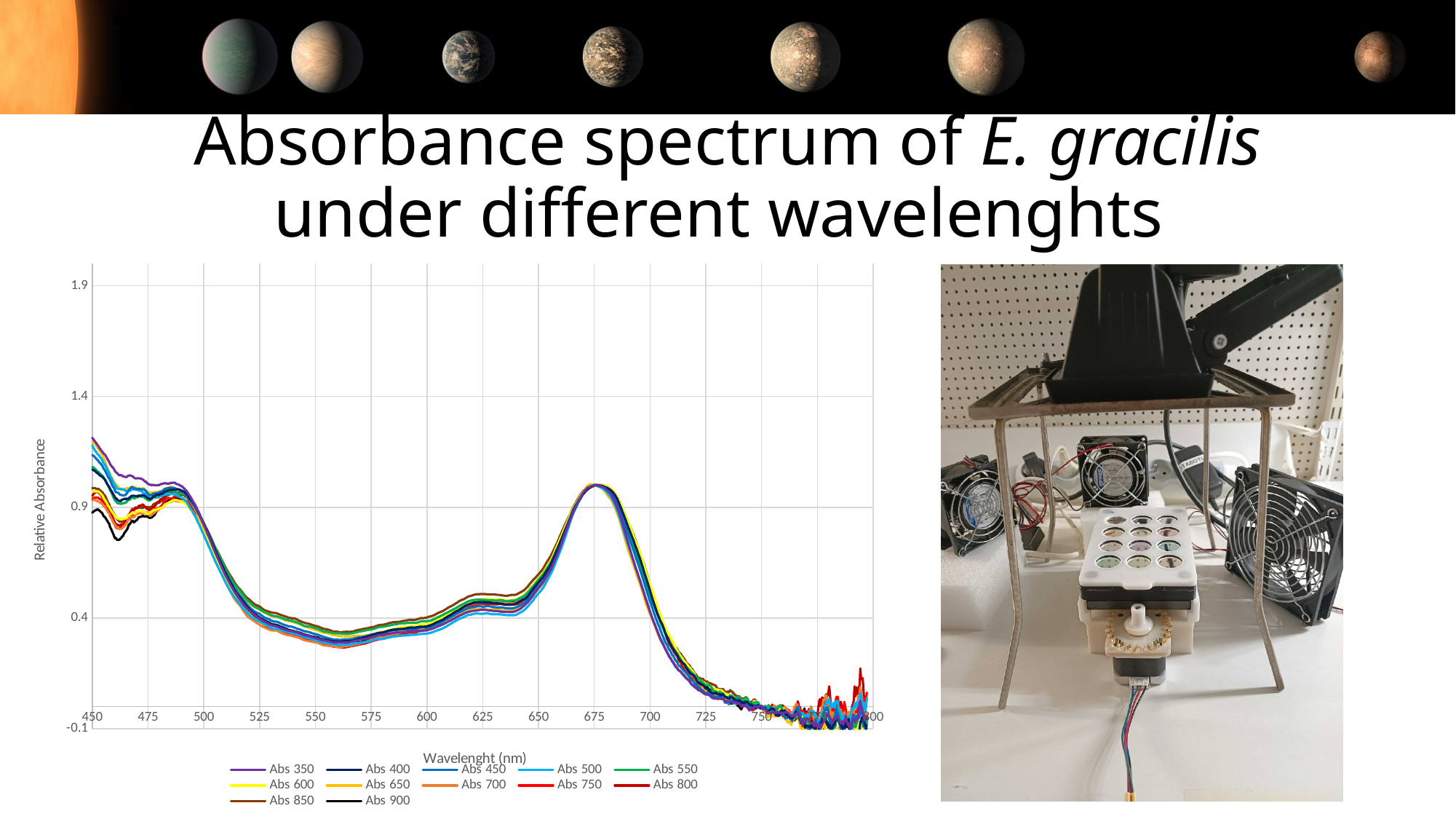
Is the value of the Abs 350 series at 450 nm greater or less than 0.9? greater Is the value of the Abs 600 series at 775 nm greater or less than 0.4? less Which series has the highest value at 450 nm? Abs 350 Is the value of the Abs 850 series at 625 nm greater or less than 0.9? less How many series does the chart legend list? 12 Do the absorbance values rise or fall between 500 nm and 550 nm? fall Do the absorbance values rise or fall between 625 nm and 675 nm? rise What is the label of the chart's y axis? Relative Absorbance What kind of chart is shown on the slide? line chart What is the label of the chart's x axis? Wavelenght (nm)